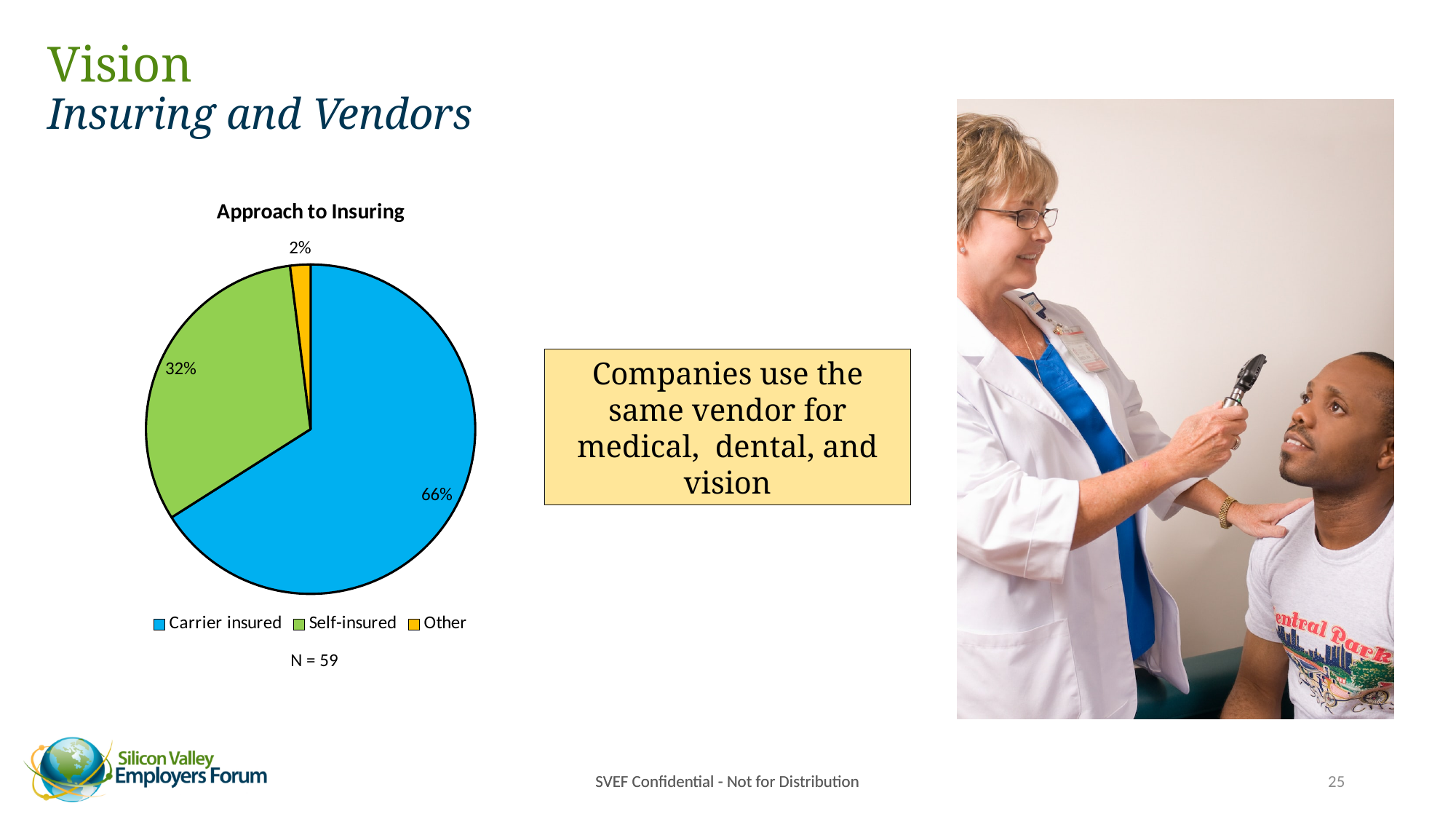
What is the sample size (N) shown below the chart? N = 59 What kind of chart is shown on the slide? Pie chart Which is larger, the Self-insured share or the Other share? Self-insured Which category has the largest share of the pie chart? Carrier insured How many categories does the pie chart show? 3 What is the combined share of Self-insured and Other? 34% What percentage of the pie chart is Other? 2% What is the difference in percentage points between Carrier insured and Self-insured? 34 What is the title of the chart? Approach to Insuring What percentage of the pie chart is Carrier insured? 66% Which category has the smallest share of the pie chart? Other What percentage of the pie chart is Self-insured? 32%